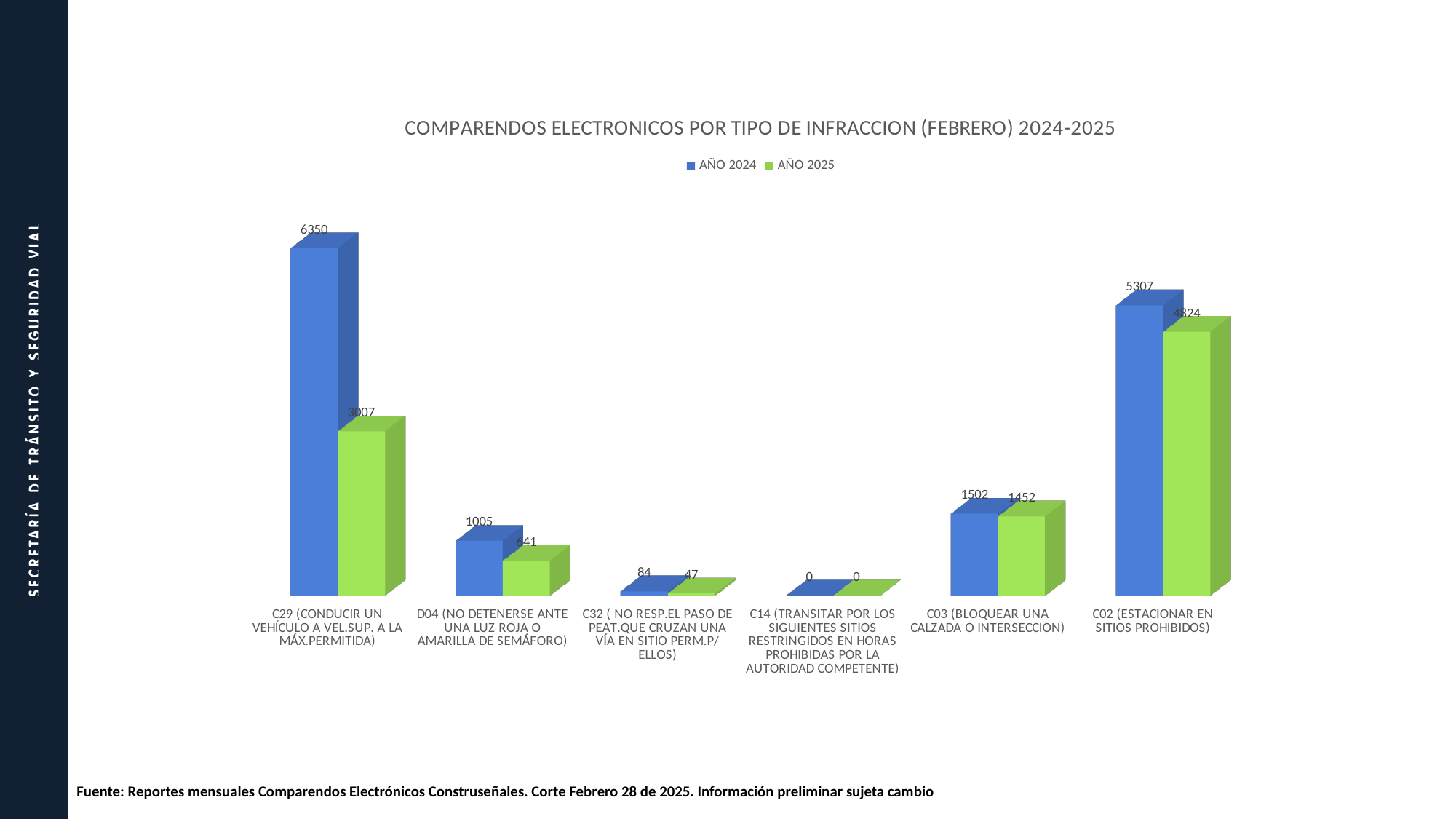
What kind of chart is shown on the slide? Bar chart What is the difference between the AÑO 2024 and AÑO 2025 values for C29? 3343 How many series does the legend list? 2 How many infraction categories are shown on the x axis? 6 What is the value for AÑO 2025 for D04 (NO DETENERSE ANTE UNA LUZ ROJA O AMARILLA DE SEMÁFORO)? 641 What is the value for AÑO 2024 for C29 (CONDUCIR UN VEHÍCULO A VEL.SUP. A LA MÁX.PERMITIDA)? 6350 What is the value for AÑO 2024 for C03 (BLOQUEAR UNA CALZADA O INTERSECCION)? 1502 What is the difference between the AÑO 2024 and AÑO 2025 values for C32 (NO RESP.EL PASO DE PEAT.QUE CRUZAN UNA VÍA EN SITIO PERM.P/ELLOS)? 37 For D04, which series has the larger value, AÑO 2024 or AÑO 2025? AÑO 2024 Which category has the highest value for AÑO 2024? C29 (CONDUCIR UN VEHÍCULO A VEL.SUP. A LA MÁX.PERMITIDA) Which category has the lowest value for AÑO 2024? C14 (TRANSITAR POR LOS SIGUIENTES SITIOS RESTRINGIDOS EN HORAS PROHIBIDAS POR LA AUTORIDAD COMPETENTE) Which category has the highest value for AÑO 2025? C02 (ESTACIONAR EN SITIOS PROHIBIDOS)